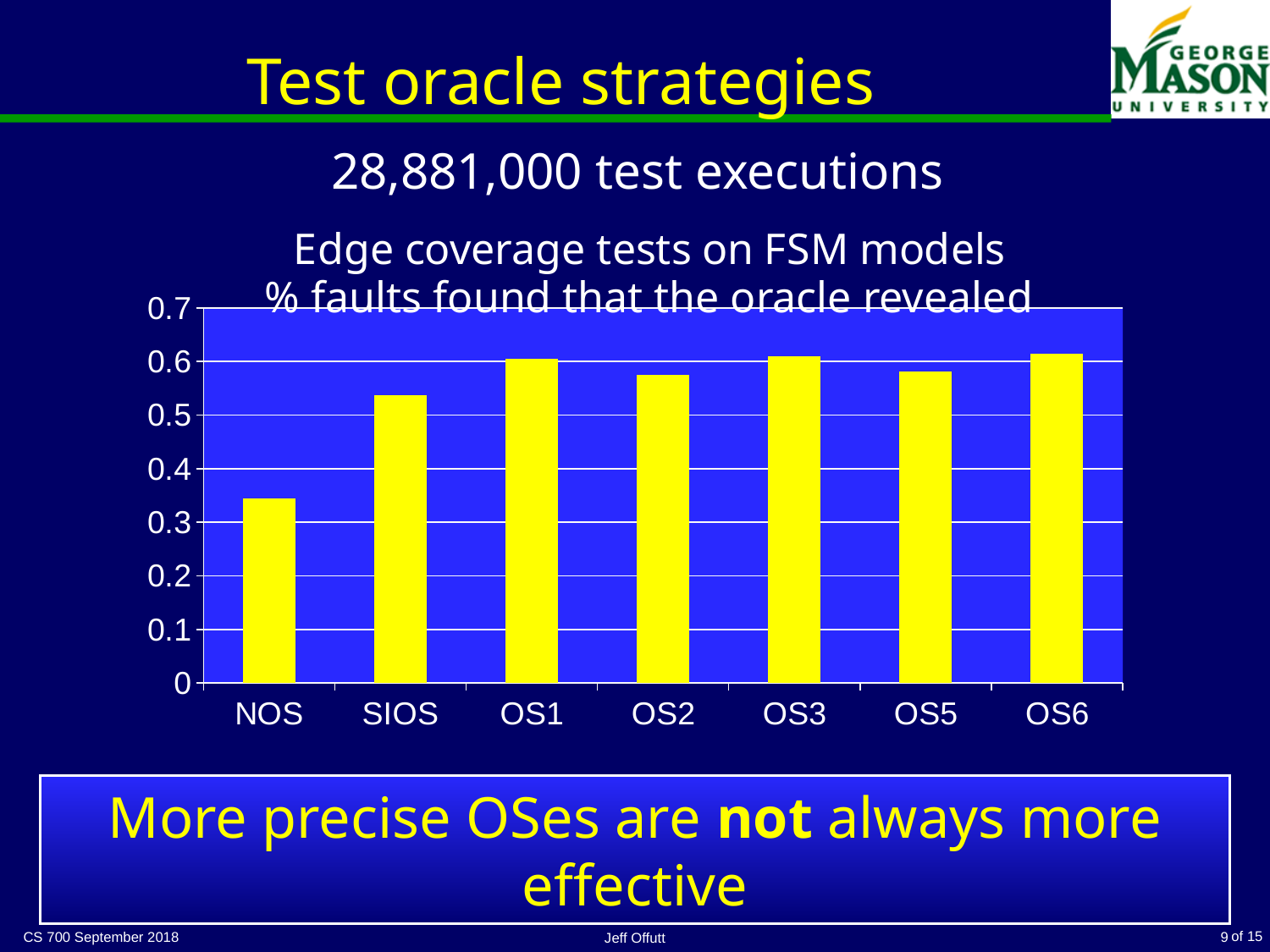
Is the value for SIOS greater or less than 0.5? greater Which has the larger value, NOS or SIOS? SIOS Which has the larger value, OS1 or OS2? OS1 Which category has the lowest value in the chart? NOS Is the value for OS2 greater or less than 0.6? less How many categories are shown on the x axis of the chart? 7 What is the title of the chart? Edge coverage tests on FSM models Is the value for NOS greater or less than 0.3? greater What kind of chart is shown on the slide? bar chart What colour are the bars in the chart? yellow